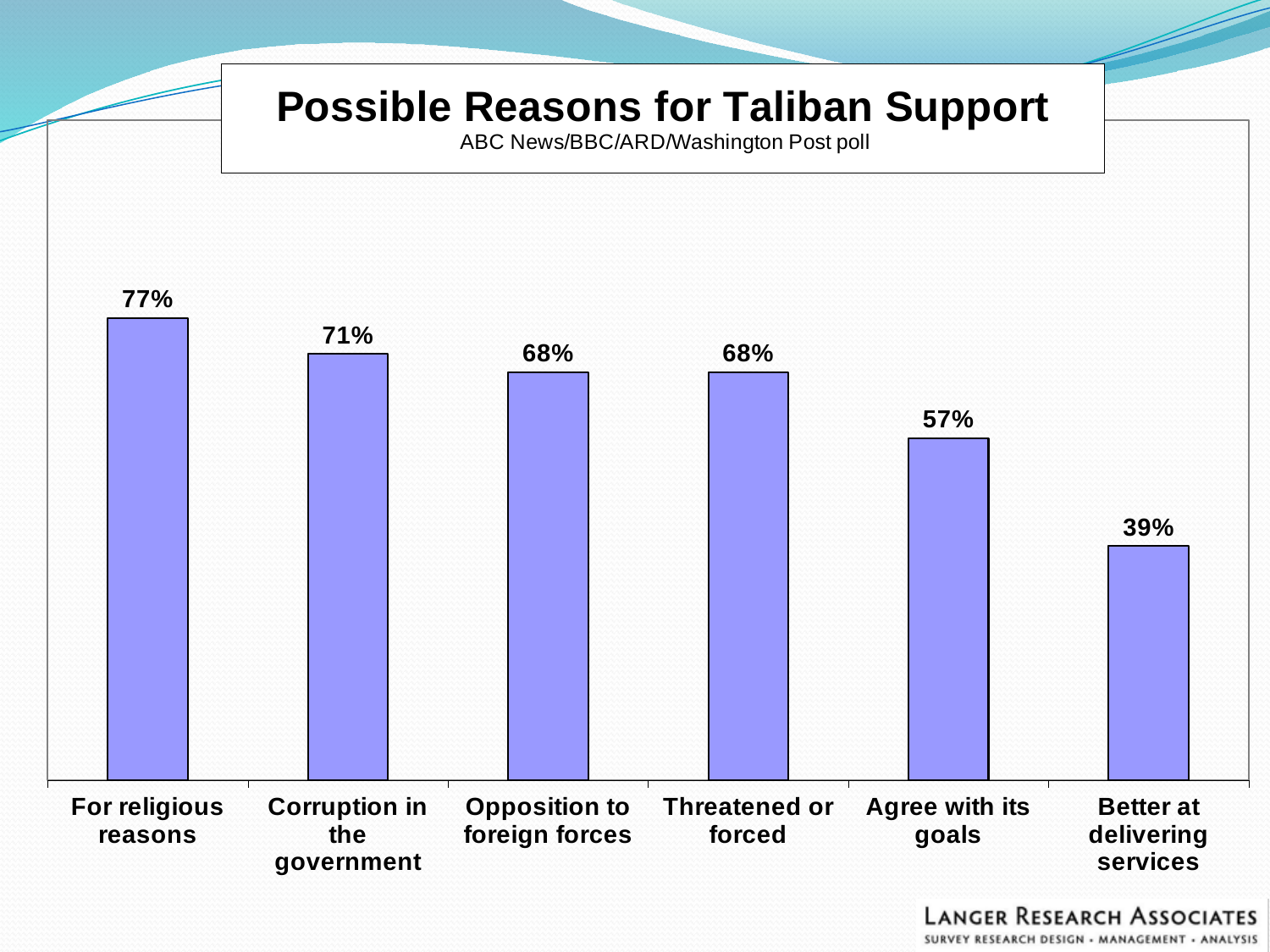
Which category has the lowest value? Better at delivering services What is the difference between "Corruption in the government" and "Agree with its goals"? 14 percentage points How many categories are shown in the chart? 6 What is the value for "Agree with its goals"? 57% What is the title of the chart? Possible Reasons for Taliban Support What is the value for "Corruption in the government"? 71% Which category has the highest value? For religious reasons What kind of chart is shown on the slide? Bar chart What is the difference between "For religious reasons" and "Better at delivering services"? 38 percentage points What is the value for "Better at delivering services"? 39% Which is larger, the value for "Corruption in the government" or the value for "Agree with its goals"? Corruption in the government What is the value for "For religious reasons"? 77%